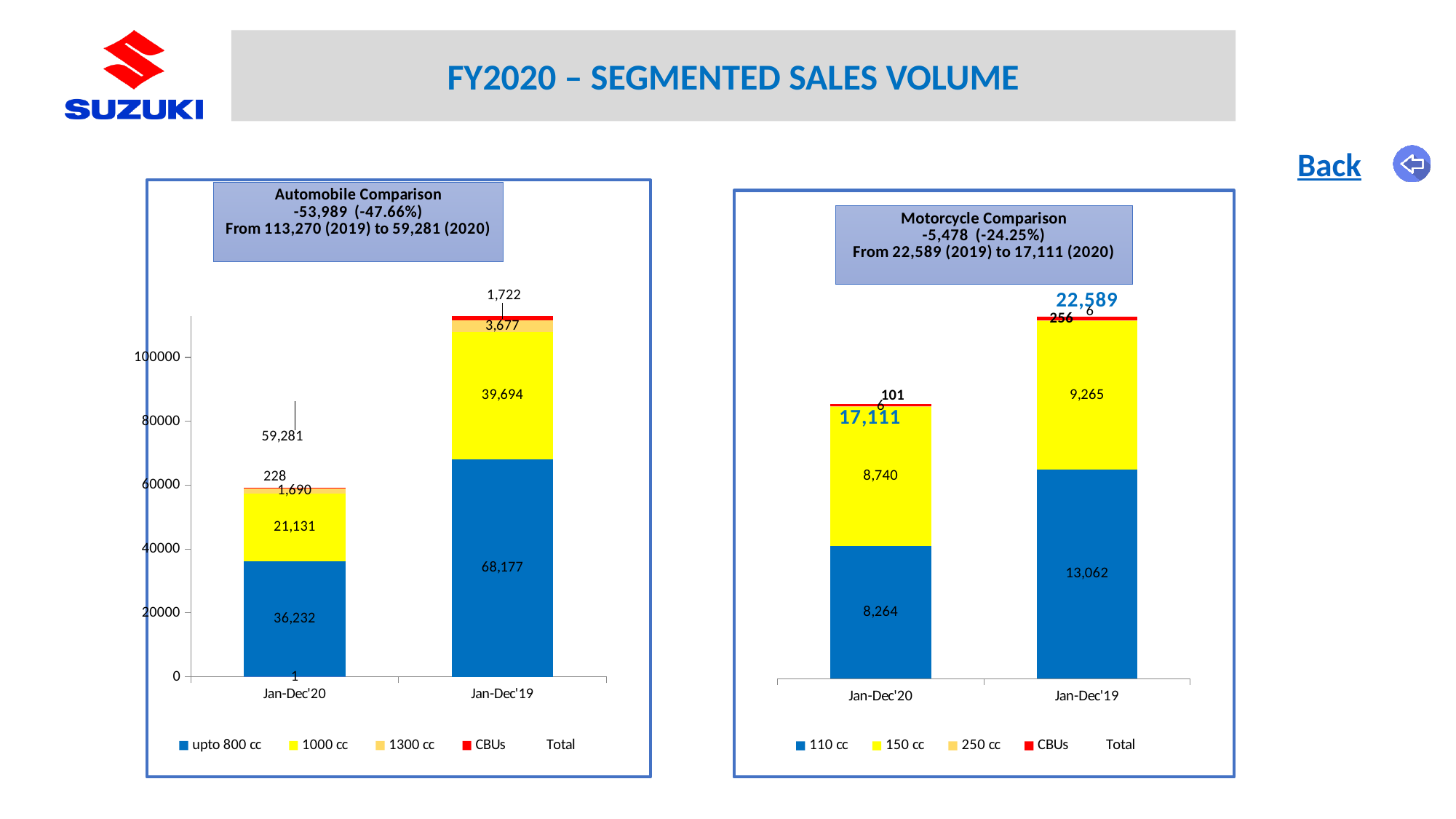
In the Automobile Comparison chart, what is the value for CBUs in Jan-Dec'19? 1,722 What kind of chart is the Automobile Comparison chart? Stacked bar chart In the Motorcycle Comparison chart, which is larger for Jan-Dec'20: 110 cc or 150 cc? 150 cc In the Motorcycle Comparison chart, what is the difference between the 110 cc values for Jan-Dec'19 and Jan-Dec'20? 4,798 In the Automobile Comparison chart, what is the value for 1000 cc in Jan-Dec'20? 21,131 In the Motorcycle Comparison chart, what is the total for the Jan-Dec'20 bar? 17,111 In the Motorcycle Comparison chart, what is the value for 110 cc in Jan-Dec'20? 8,264 In the Automobile Comparison chart, is the total for the Jan-Dec'19 bar greater or less than 100000? greater In the Automobile Comparison chart, what is the difference between the upto 800 cc values for Jan-Dec'19 and Jan-Dec'20? 31,945 How many series does the legend of the Motorcycle Comparison chart list? 5 In the Automobile Comparison chart, what is the value for upto 800 cc in Jan-Dec'19? 68,177 In the Motorcycle Comparison chart, what is the value for 150 cc in Jan-Dec'19? 9,265